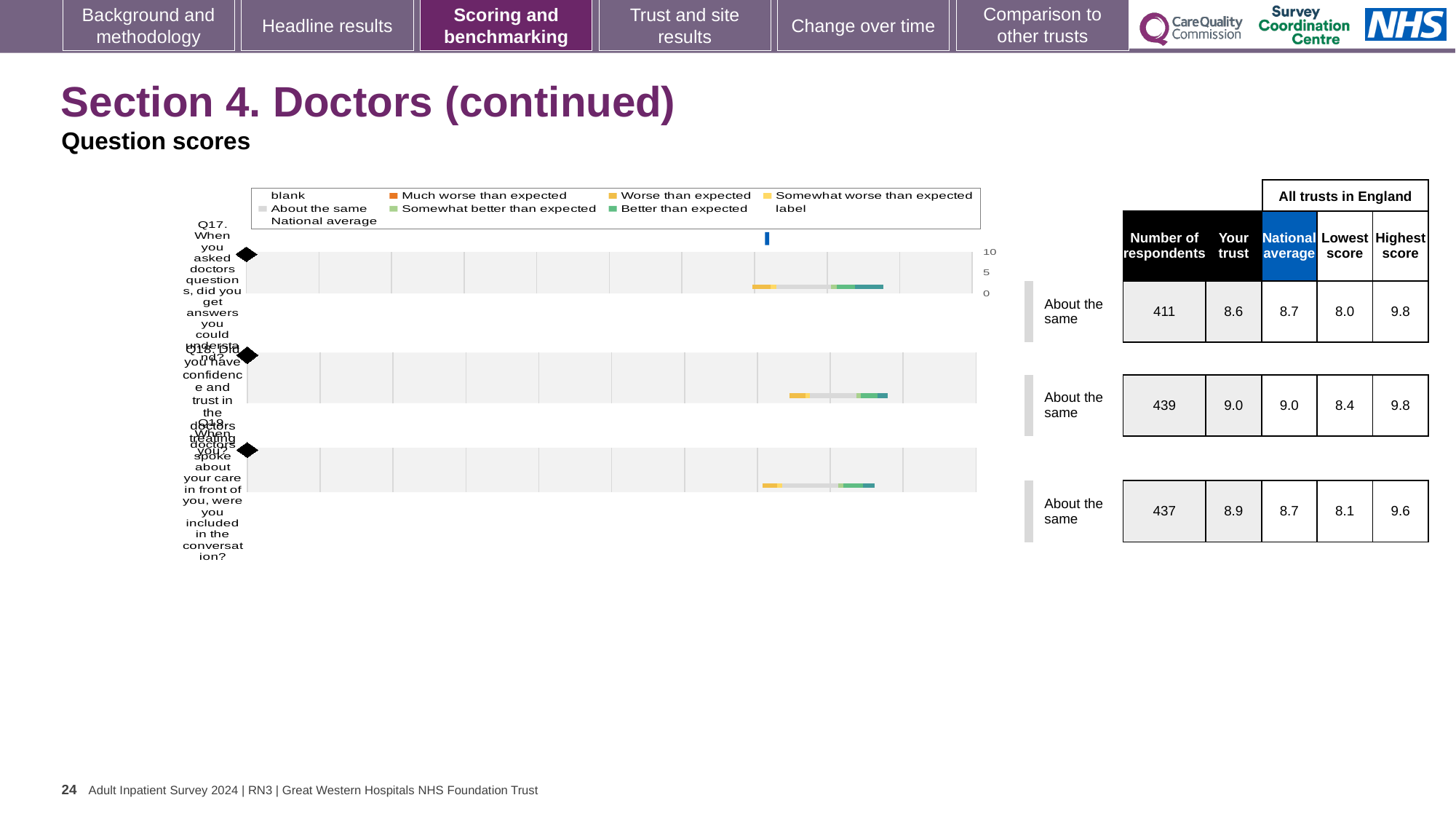
What benchmark category is shown for Q17, Q18 and Q19? About the same What is the number of respondents for Q19 (When doctors spoke about your care in front of you, were you included in the conversation?)? 437 Which question has the lowest number of respondents? Q17 What is the difference between the 'Your trust' score and the national average for Q19? 0.2 Which question has the highest 'Your trust' score? Q18 What is the 'Your trust' score for Q17 (When you asked doctors questions, did you get answers you could understand?)? 8.6 What is the national average score for Q18 (Did you have confidence and trust in the doctors treating you?)? 9.0 What kind of chart is used to show the question scores for Q17, Q18 and Q19? bar chart What is the highest score across all trusts in England for Q19? 9.6 What is the lowest score across all trusts in England for Q17? 8.0 How many questions (Q17, Q18, Q19) are plotted on the slide? 3 Is the 'Your trust' score for Q18 larger or smaller than the 'Your trust' score for Q17? larger